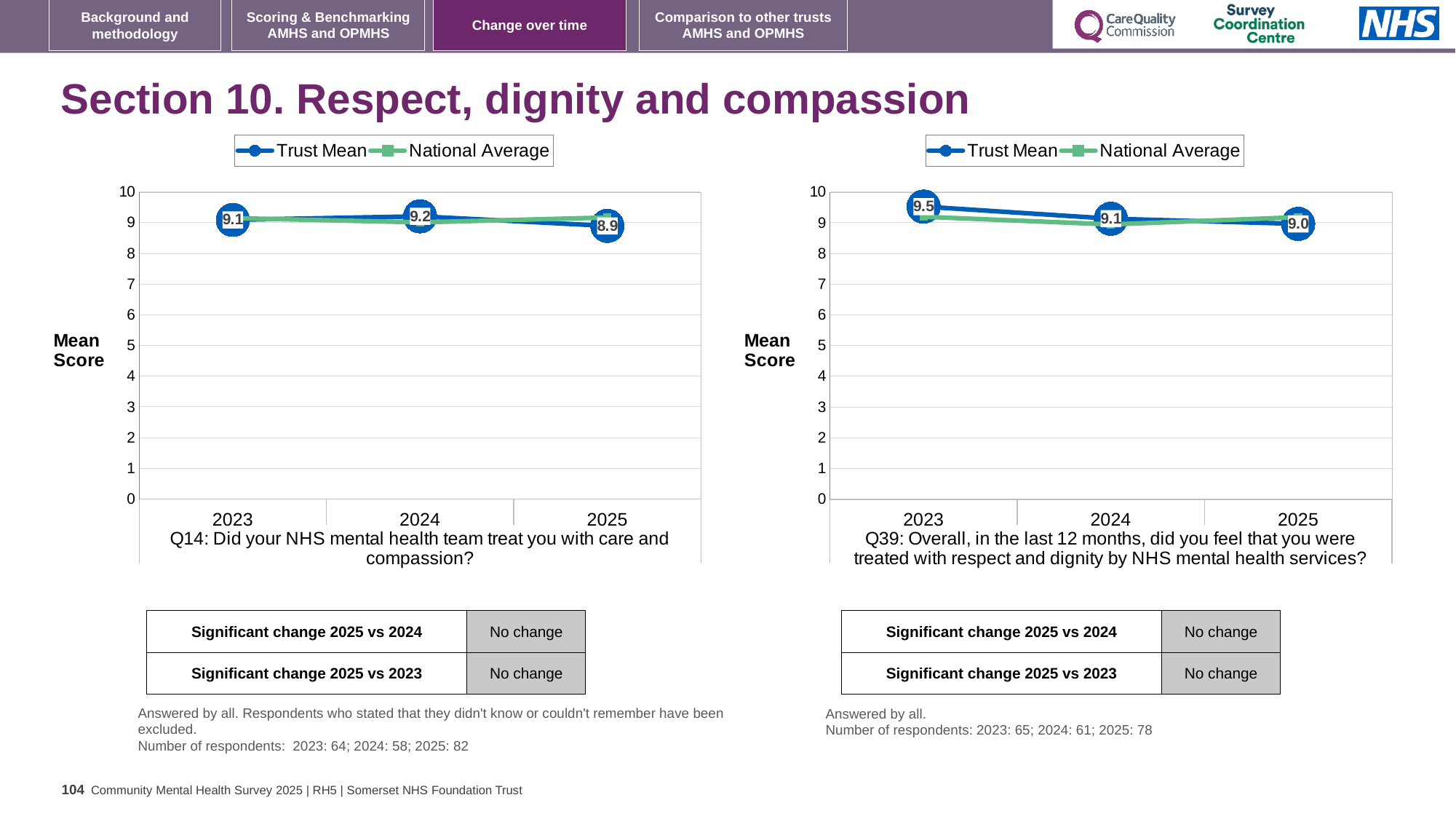
In the right chart (Q39), what is the Trust Mean for 2023? 9.5 In the right chart (Q39), is the Trust Mean for 2023 greater or less than 9? greater How many years are plotted on the x axis of the left chart (Q14)? 3 How many series does the legend of the right chart (Q39) list? 2 In the right chart (Q39), which year has the highest Trust Mean? 2023 In the left chart (Q14), is the Trust Mean higher in 2024 or 2025? 2024 In the left chart (Q14), what is the Trust Mean for 2024? 9.2 In the right chart (Q39), what is the Trust Mean for 2025? 9.0 In the left chart (Q14), what is the Trust Mean for 2025? 8.9 In the left chart (Q14), which year has the lowest Trust Mean? 2025 In the right chart (Q39), what is the difference between the Trust Mean for 2023 and 2025? 0.5 What kind of chart is the left chart (Q14)? Line chart